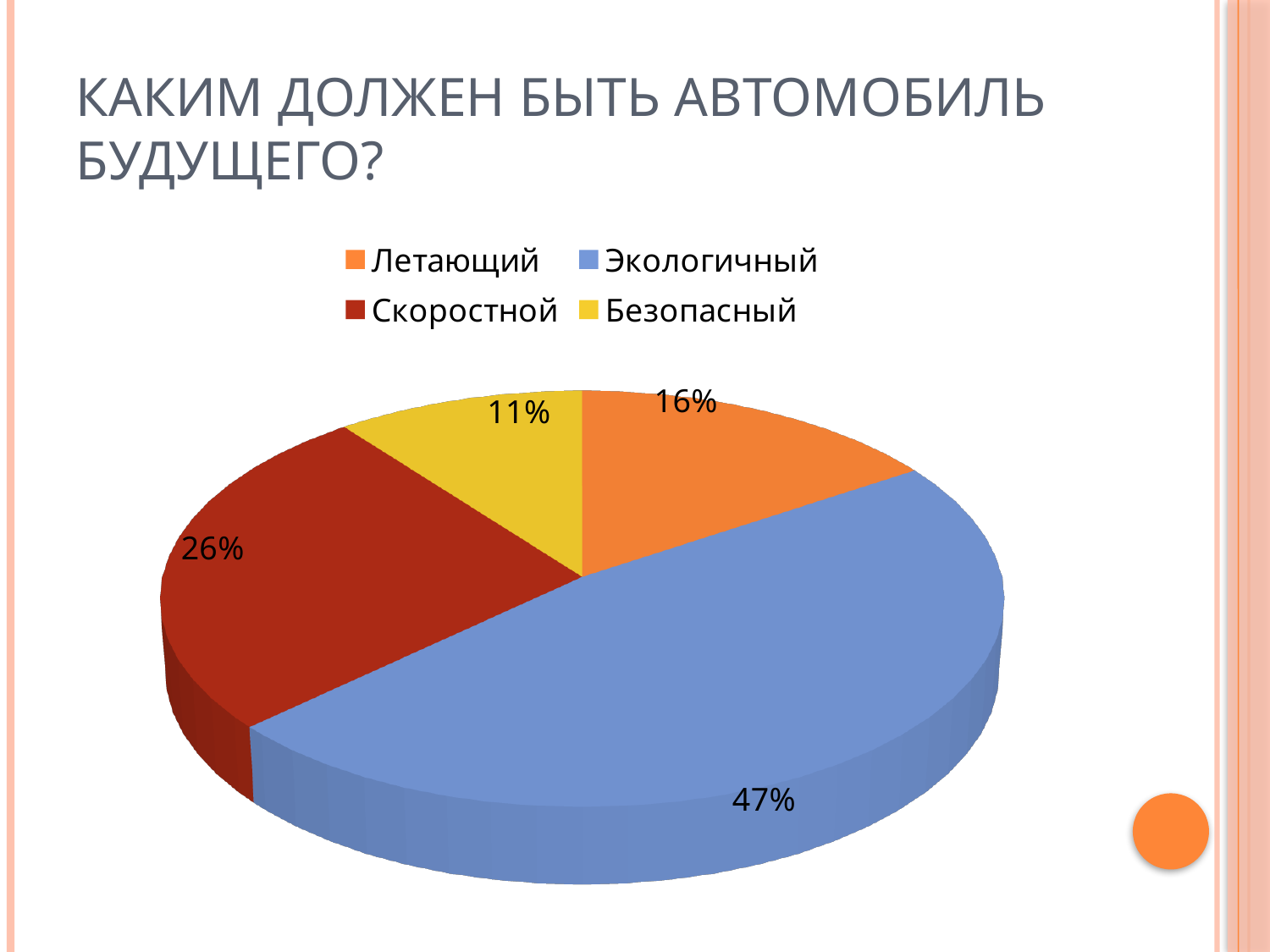
What share of the pie does Скоростной have? 26% What is the difference between the shares of Летающий and Безопасный? 5% What share of the pie does Экологичный have? 47% What share of the pie does Безопасный have? 11% How many categories does the pie chart have? 4 What colour is the slice for Безопасный? yellow What kind of chart is shown on the slide? pie chart What is the difference between the shares of Экологичный and Скоростной? 21% Which category has the largest slice of the pie? Экологичный Which category has the smallest slice of the pie? Безопасный Which is larger, the share for Скоростной or the share for Летающий? Скоростной